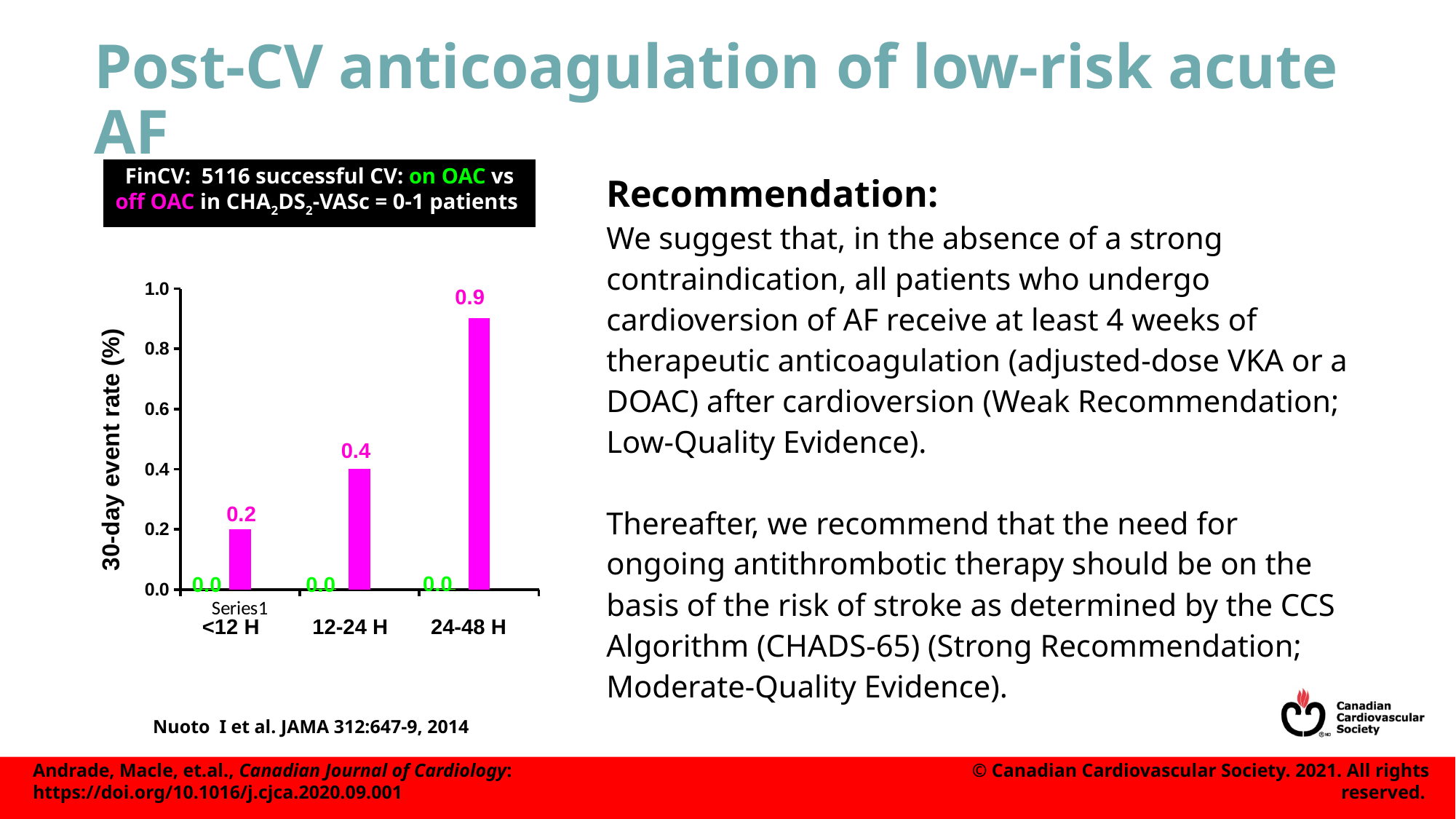
What is the label of the y axis of the chart? 30-day event rate (%) What type of chart is shown on the slide? Bar chart What is the 30-day event rate for off OAC patients in the 12-24 H group? 0.4 Which time group has the lowest 30-day event rate for off OAC patients? <12 H Which time group has the highest 30-day event rate for off OAC patients? 24-48 H Which is larger: the off OAC event rate in the 12-24 H group or in the 24-48 H group? 24-48 H What is the difference in 30-day event rate for off OAC patients between the 24-48 H and <12 H groups? 0.7 What is the 30-day event rate for off OAC patients in the 24-48 H group? 0.9 Do the off OAC 30-day event rates rise or fall as the time group increases from <12 H to 24-48 H? Rise What is the 30-day event rate for off OAC patients in the <12 H group? 0.2 How many time groups are shown on the x axis of the chart? 3 What is the 30-day event rate for on OAC patients in the 12-24 H group? 0.0